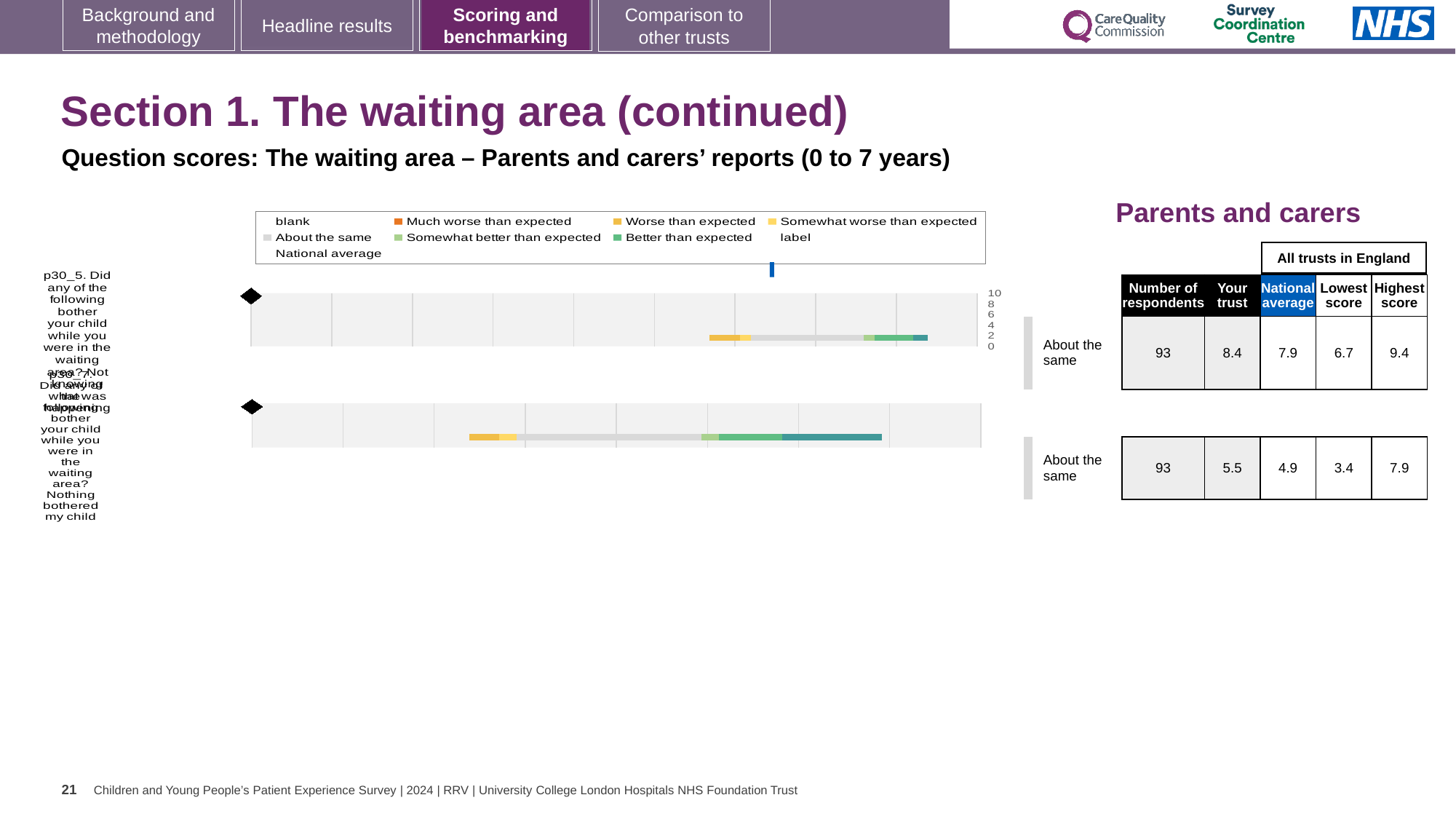
For the bottom chart (p30_7), what is the 'Your trust' score shown in the table? 5.5 For the bottom chart (p30_7), what is the lowest score among all trusts in England? 3.4 For the top chart (p30_5), what is the national average score shown in the table? 7.9 How many respondents are shown for the top chart (p30_5)? 93 For the top chart (p30_5), what is the 'Your trust' score shown in the table? 8.4 Which chart has the higher 'Your trust' score, the top chart (p30_5) or the bottom chart (p30_7)? the top chart (p30_5) What is the last entry listed in the chart legend? National average What kind of chart is used on this slide to show the question scores? bar chart For the bottom chart (p30_7), what is the difference between the highest score and the lowest score among all trusts in England? 4.5 How many bar charts are shown on the slide? 2 For the top chart (p30_5), what is the difference between the 'Your trust' score and the national average? 0.5 What is the highest value shown on the chart's score axis? 10